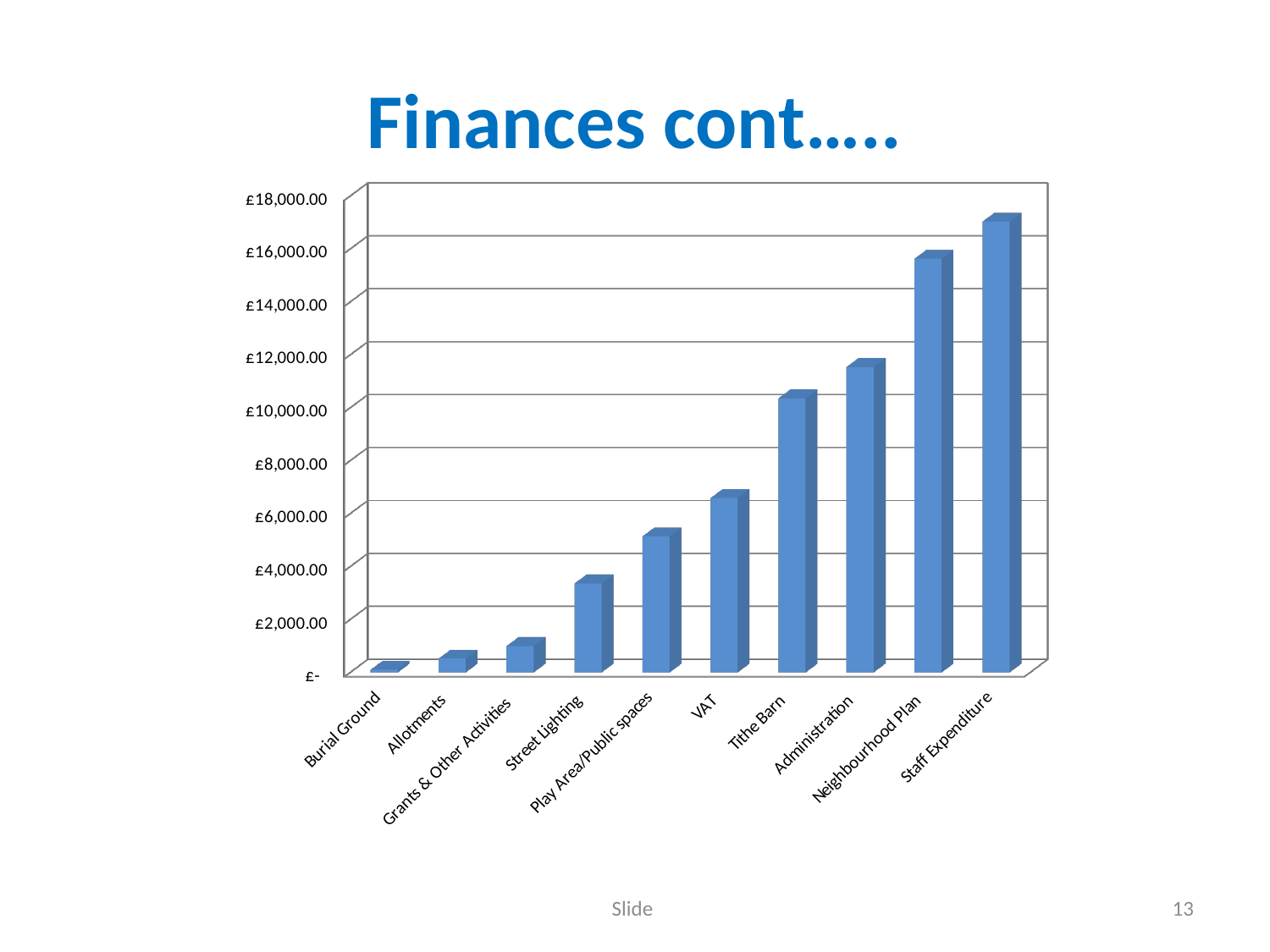
Is the value for Tithe Barn greater or less than £8,000.00? greater Is the value for Play Area/Public spaces greater or less than £4,000.00? greater Is the value for Staff Expenditure greater or less than £16,000.00? greater What kind of chart is shown on the slide? Bar chart Do the values rise or fall moving from left to right along the x axis? Rise How many categories are plotted on the chart? 10 Which category has the highest value? Staff Expenditure Which is larger, the value for Tithe Barn or the value for VAT? Tithe Barn Which category has the lowest value? Burial Ground